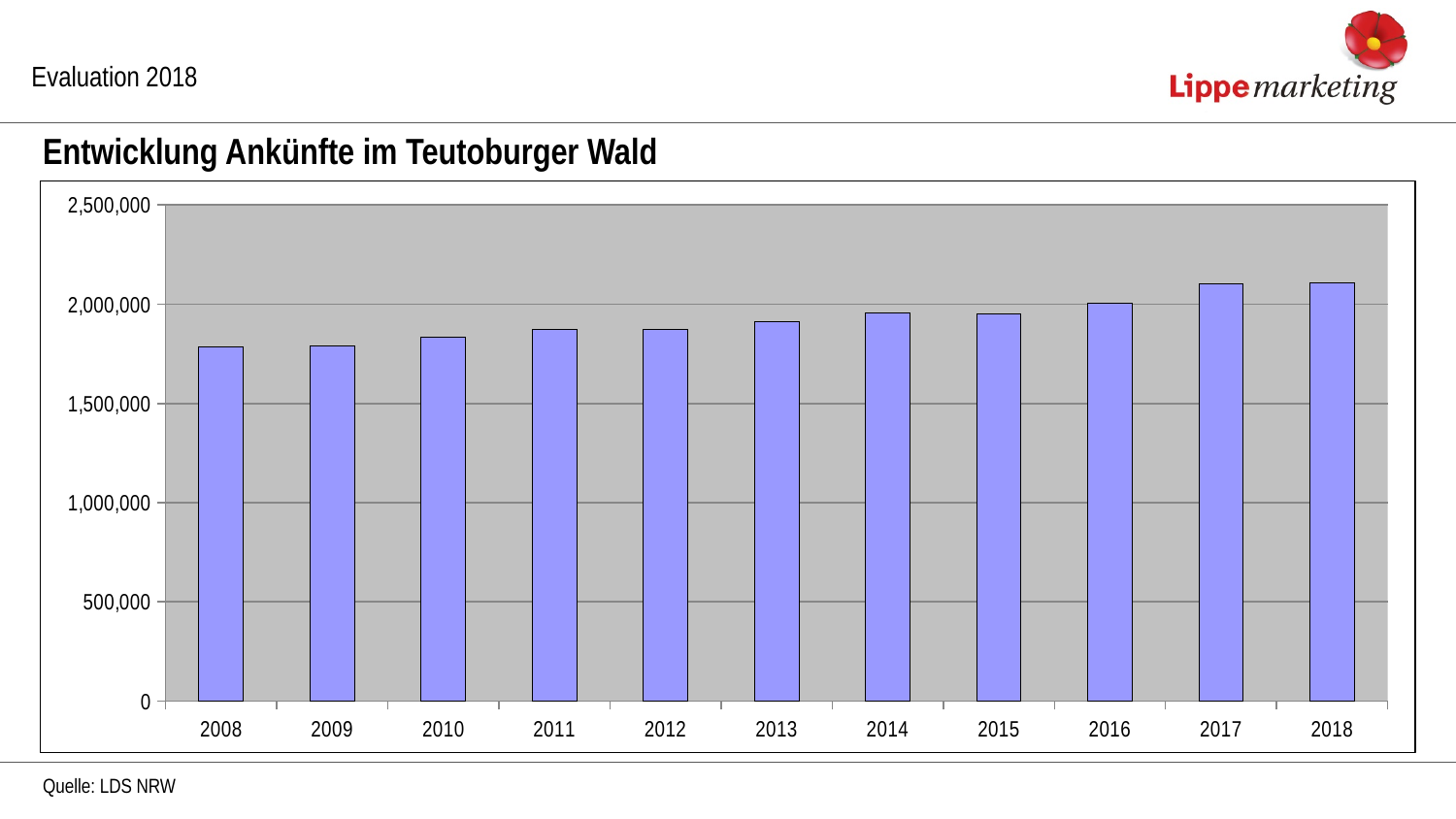
Is the value for 2008 greater or less than 2,000,000? less Is the value for 2018 greater or less than 2,500,000? less Which year has the larger value, 2008 or 2017? 2017 What is the highest value shown on the y axis? 2,500,000 What kind of chart is shown on the slide? bar chart What is the title of the chart? Entwicklung Ankünfte im Teutoburger Wald How many years are shown on the x axis of the chart? 11 Which year has the larger value, 2012 or 2016? 2016 Is the value for 2014 greater or less than 1,500,000? greater Do the values generally rise or fall from 2008 to 2018? rise Which year has the larger value, 2010 or 2013? 2013